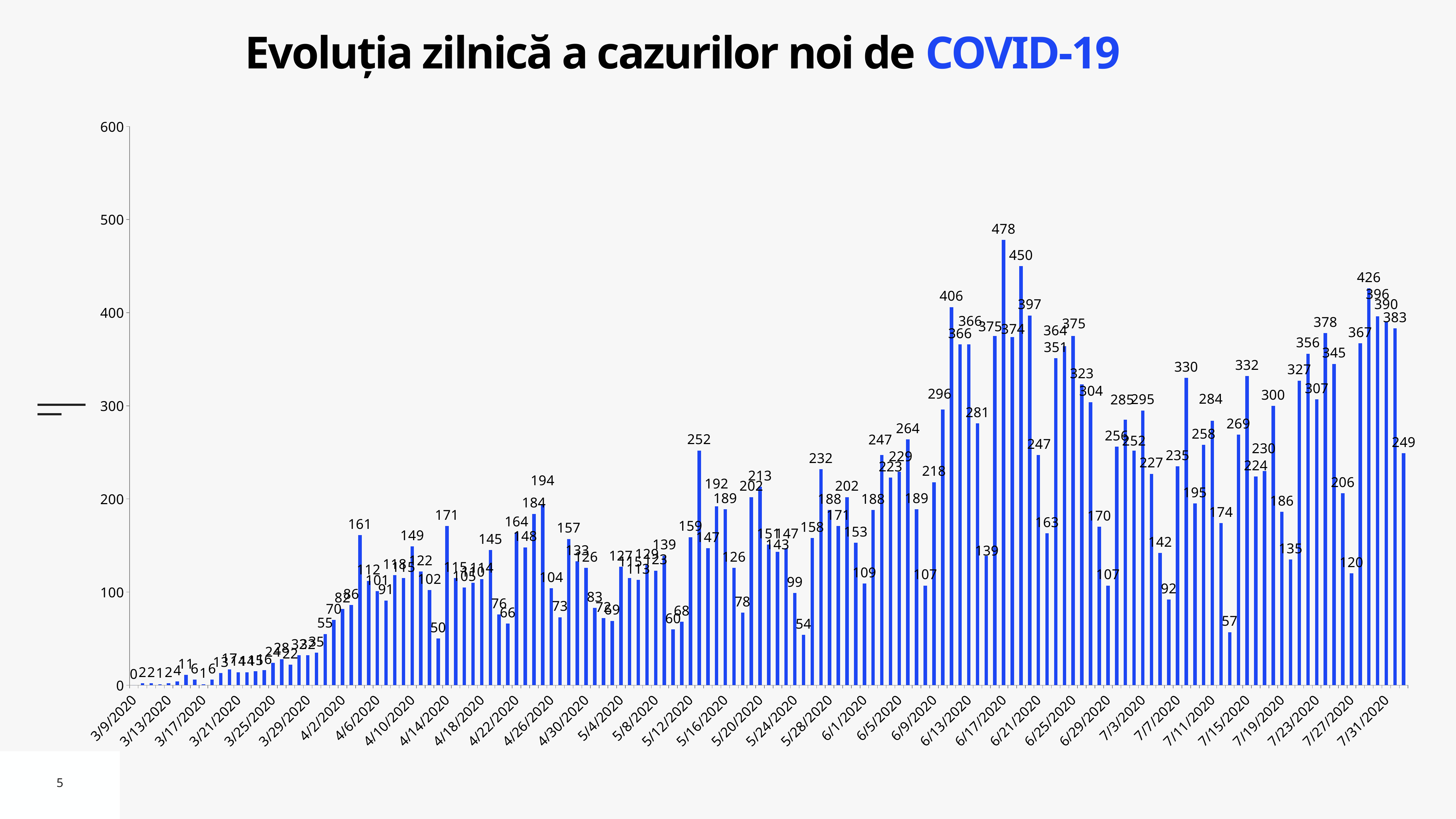
What is the maximum value shown on the vertical axis? 600 What is the last date label shown on the horizontal axis? 7/31/2020 Do the daily values generally rise or fall from March to the end of July? rise What is the value of the last bar on the chart? 249 What is the value of the first bar on the chart (3/9/2020)? 0 What is the lowest daily value shown on the chart? 0 What is the highest daily value shown on the chart? 478 What is the title of the chart? Evoluția zilnică a cazurilor noi de COVID-19 What kind of chart is shown on the slide? bar chart What is the difference between the two highest values on the chart, 478 and 450? 28 Which is larger, the peak value of 478 or the later peak of 426? 478 Is the highest bar on the chart greater or less than 400? greater